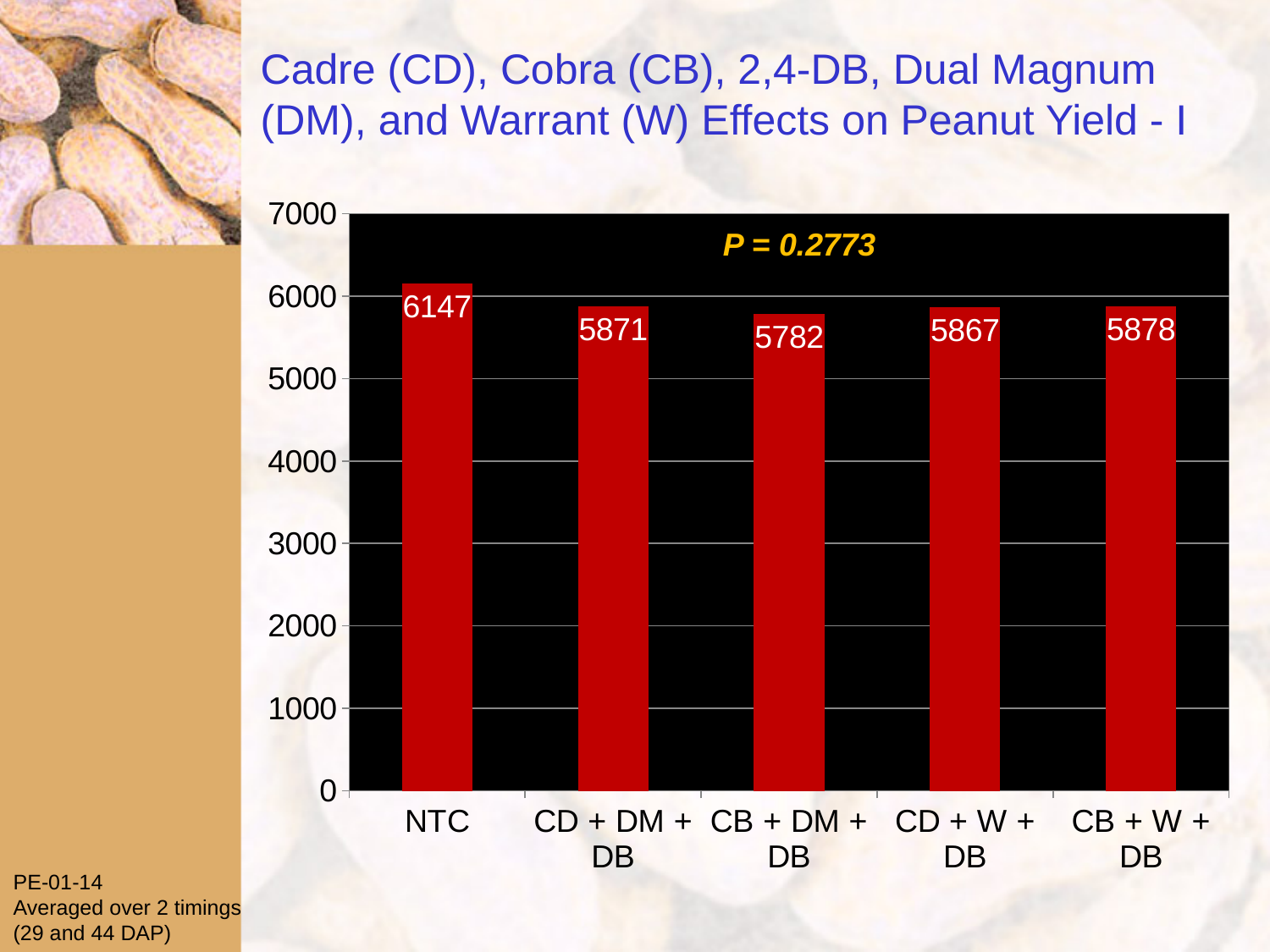
What P value is printed on the chart? P = 0.2773 Which has a larger value, CD + DM + DB or CB + DM + DB? CD + DM + DB How many treatments are shown on the x axis? 5 Which treatment has the highest yield? NTC What is the difference between the NTC yield and the CD + DM + DB yield? 276 What is the value shown for CD + W + DB? 5867 What is the peanut yield value for NTC? 6147 What is the value shown for CB + DM + DB? 5782 Is the value for NTC greater or less than 6000? greater What kind of chart is shown on the slide? bar chart What is the value shown for CB + W + DB? 5878 Which treatment has the lowest yield? CB + DM + DB